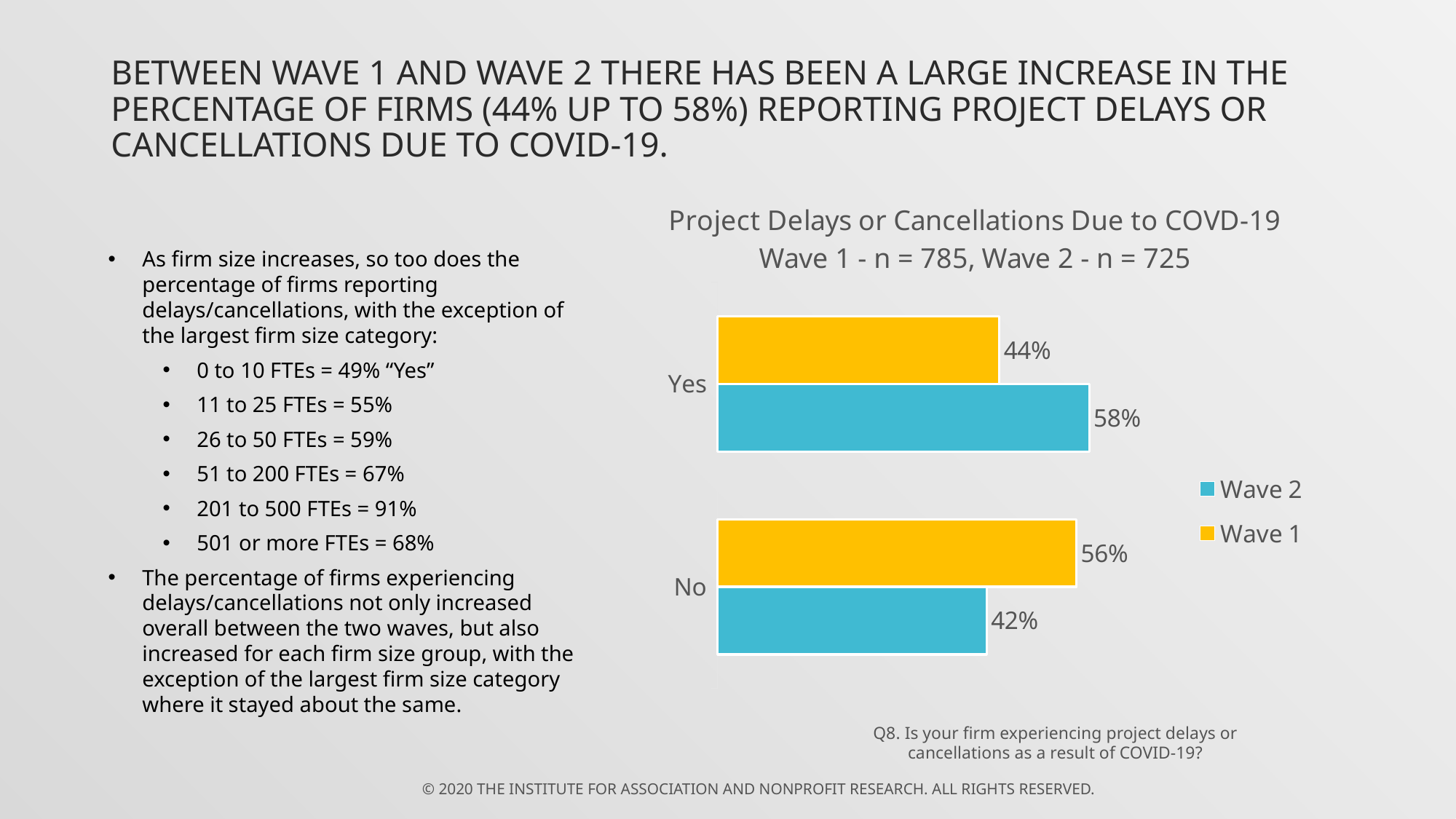
Which is larger for the Yes category: Wave 1 or Wave 2? Wave 2 What is the difference between the Wave 1 and Wave 2 values for No? 14 percentage points What percentage of firms answered No in Wave 1? 56% What kind of chart is shown on the slide? Bar chart How many series does the legend list? 2 Which is larger for the No category: Wave 1 or Wave 2? Wave 1 What percentage of firms answered Yes in Wave 1? 44% What percentage of firms answered Yes in Wave 2? 58% By how many percentage points did the Yes response increase from Wave 1 to Wave 2? 14 percentage points Which category has the highest value in Wave 2? Yes What percentage of firms answered No in Wave 2? 42% What colour represents Wave 1 in the chart? Yellow